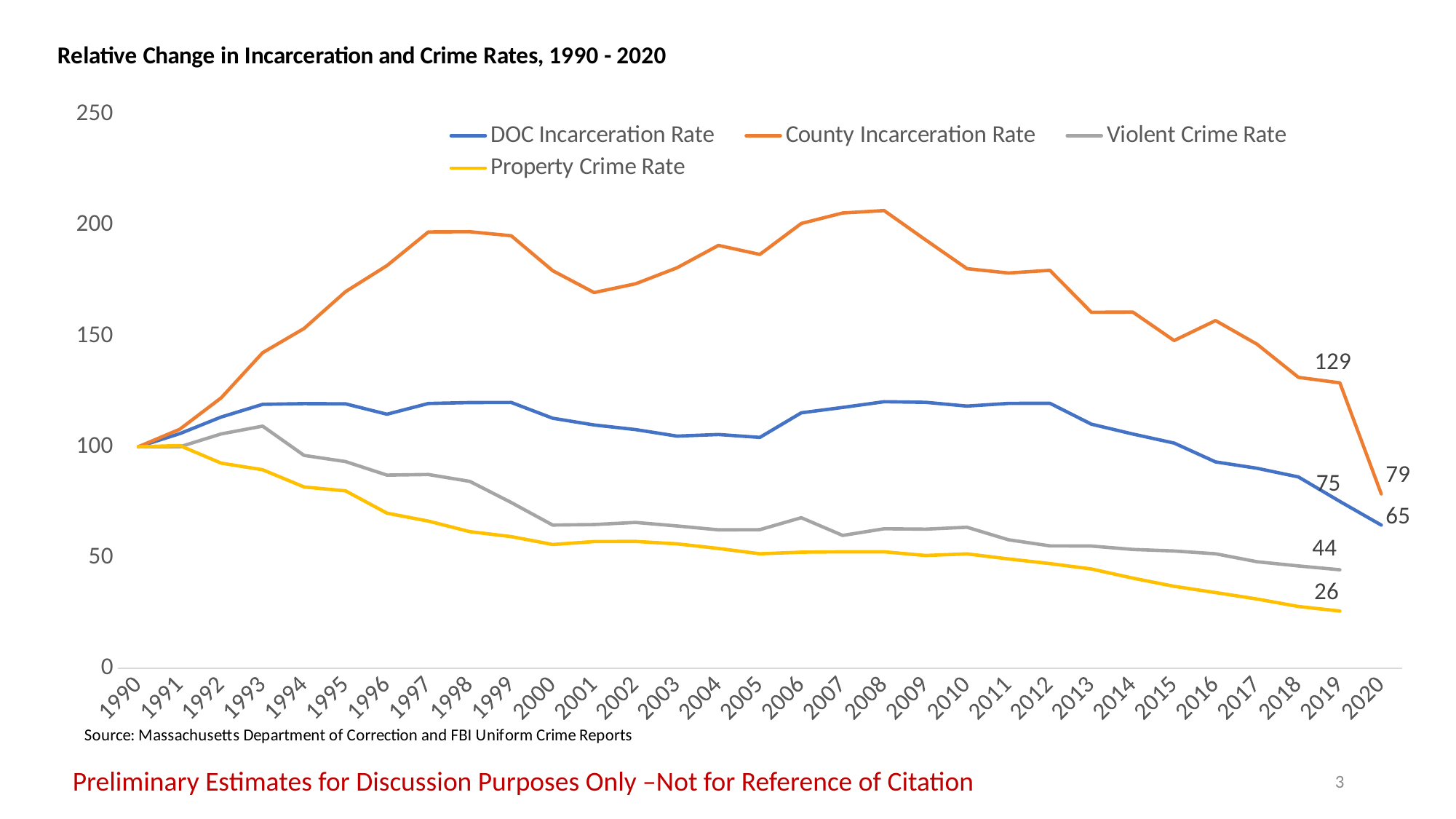
What is the labelled value of the County Incarceration Rate in 2019? 129 How many series does the legend list? 4 Which series has the lowest value at the end of the chart in 2020? DOC Incarceration Rate What is the title of the chart? Relative Change in Incarceration and Crime Rates, 1990 - 2020 What is the data label shown at the end of the Property Crime Rate line? 26 What type of chart is shown on the slide? Line chart What is the labelled value of the DOC Incarceration Rate in 2019? 75 What is the difference between the County Incarceration Rate and the DOC Incarceration Rate in 2020? 14 What is the value of the DOC Incarceration Rate in 2020? 65 Is the County Incarceration Rate in 2008 greater or less than 200? greater What is the value of the County Incarceration Rate in 2020? 79 Does the Property Crime Rate rise or fall from 1990 to 2020? Fall